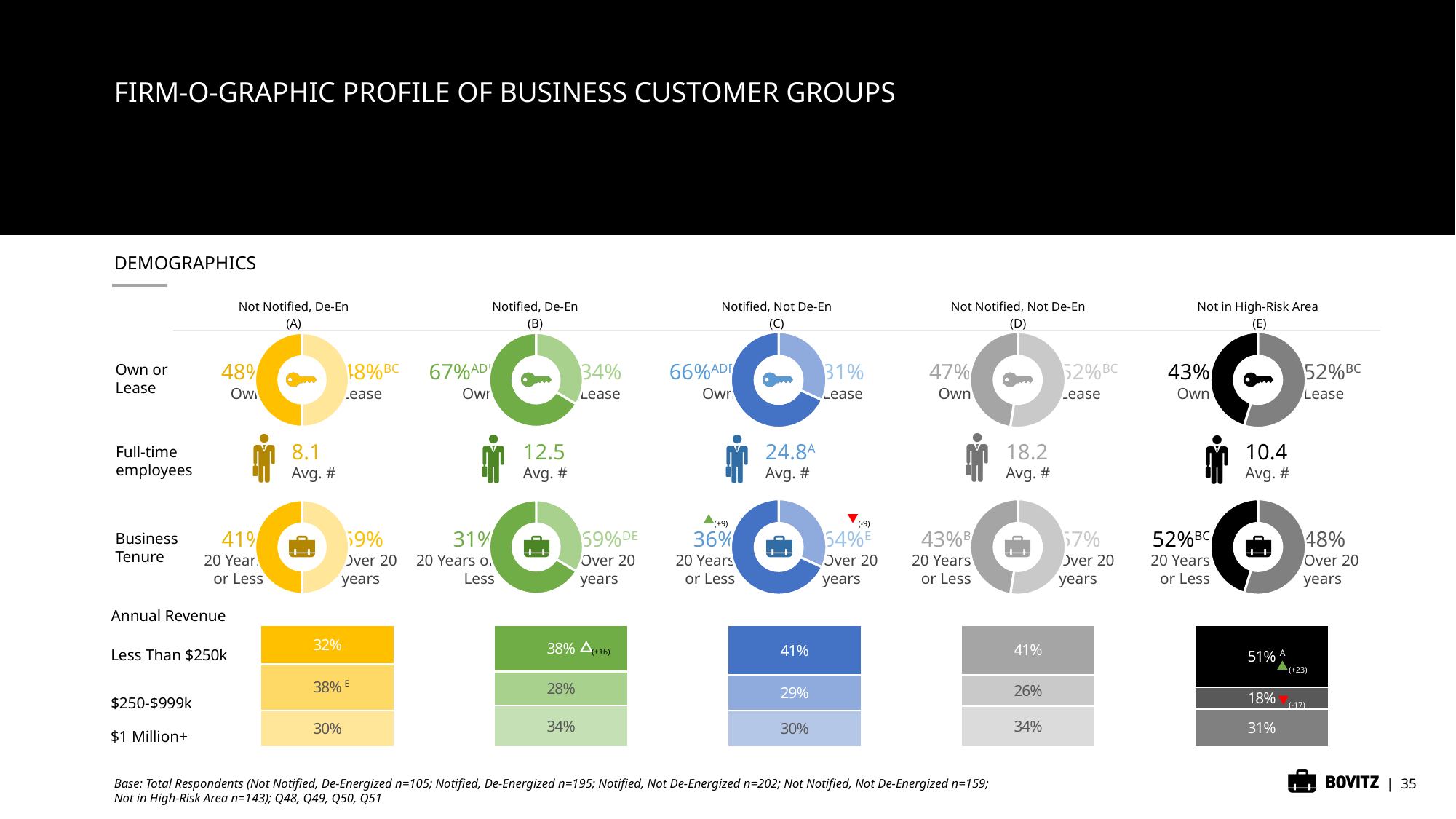
What kind of chart is used to show Own or Lease for each customer group? Donut chart In the Full-time employees row, which customer group has the lowest average number of full-time employees? Not Notified, De-En (A) In the Full-time employees row, what is the average number of full-time employees for the Notified, Not De-En (C) group? 24.8 In the Own or Lease donut chart for the Not in High-Risk Area (E) group, what percentage of businesses lease? 52% In the Own or Lease donut chart for the Notified, De-En (B) group, what percentage of businesses own? 67% In the Full-time employees row, which customer group has the highest average number of full-time employees? Notified, Not De-En (C) In the Annual Revenue stacked bars, which group has the larger Less Than $250k share: Notified, De-En (B) or Notified, Not De-En (C)? Notified, Not De-En (C) In the Annual Revenue stacked bar for the Not Notified, De-En (A) group, what is the difference between the $250-$999k share and the $1 Million+ share? 8% In the Business Tenure donut chart for the Not in High-Risk Area (E) group, what percentage of businesses have been in business 20 years or less? 52% In the Annual Revenue stacked bar for the Not Notified, Not De-En (D) group, what is the total of the three revenue segments? 101% How many business customer groups are compared across the Demographics section? 5 In the Annual Revenue stacked bar for the Not in High-Risk Area (E) group, what percentage of businesses have revenue of less than $250k? 51%